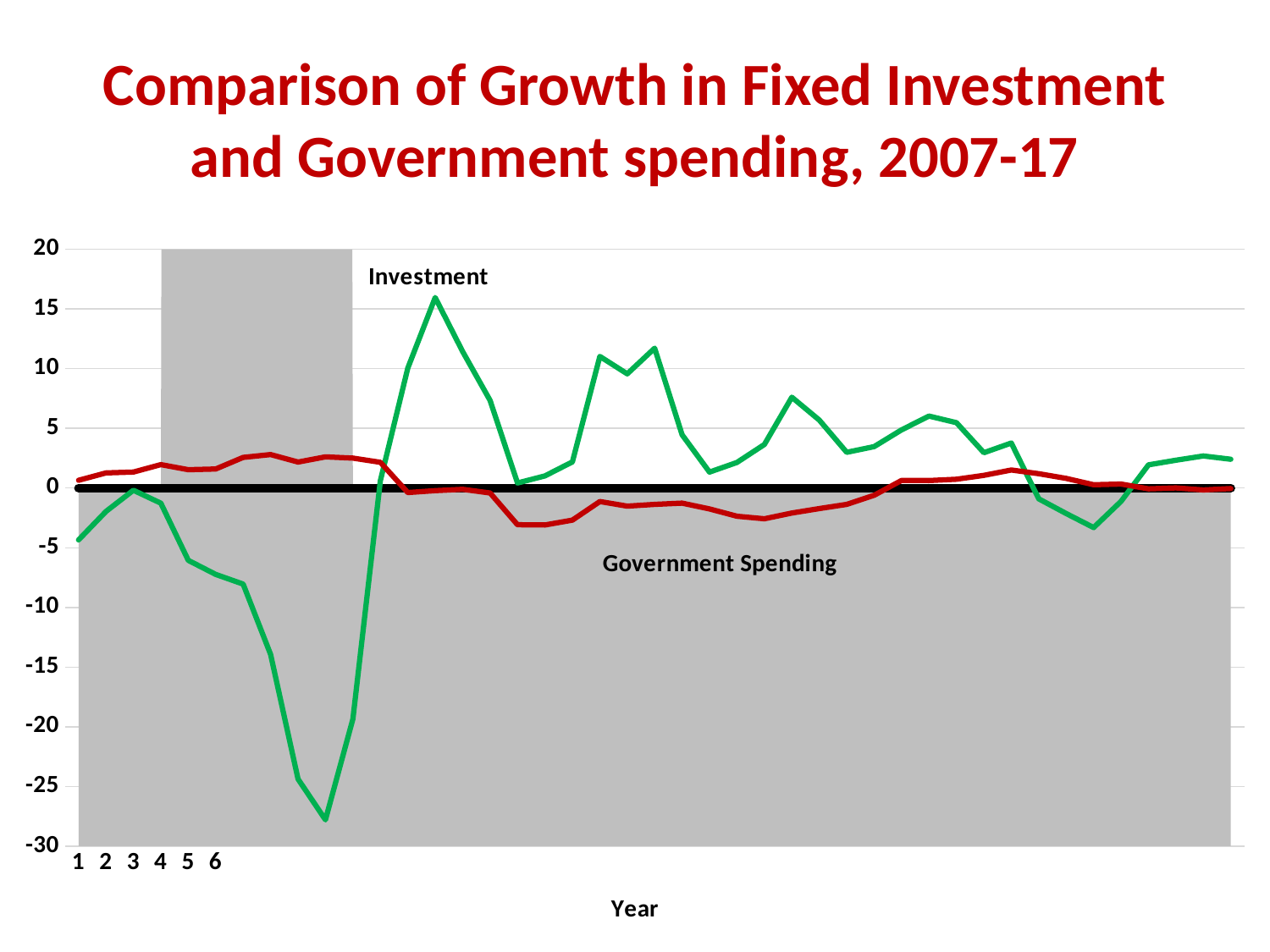
How many data series are plotted on the chart? 2 Is the highest value of the Investment line greater or less than 10? greater Which series reaches the highest value on the chart, Investment or Government Spending? Investment Which series reaches the lowest value on the chart, Investment or Government Spending? Investment Is the lowest value of the Investment line greater or less than -25? less Does the Investment line rise or fall between year 3 and its lowest point in the shaded region? Fall Is the value of Investment at year 1 greater or less than 0? less What colour is the Investment line? Green Which series shows larger swings over the period, Investment or Government Spending? Investment What kind of chart is shown on the slide? Line chart What is the title of the chart on the slide? Comparison of Growth in Fixed Investment and Government spending, 2007-17